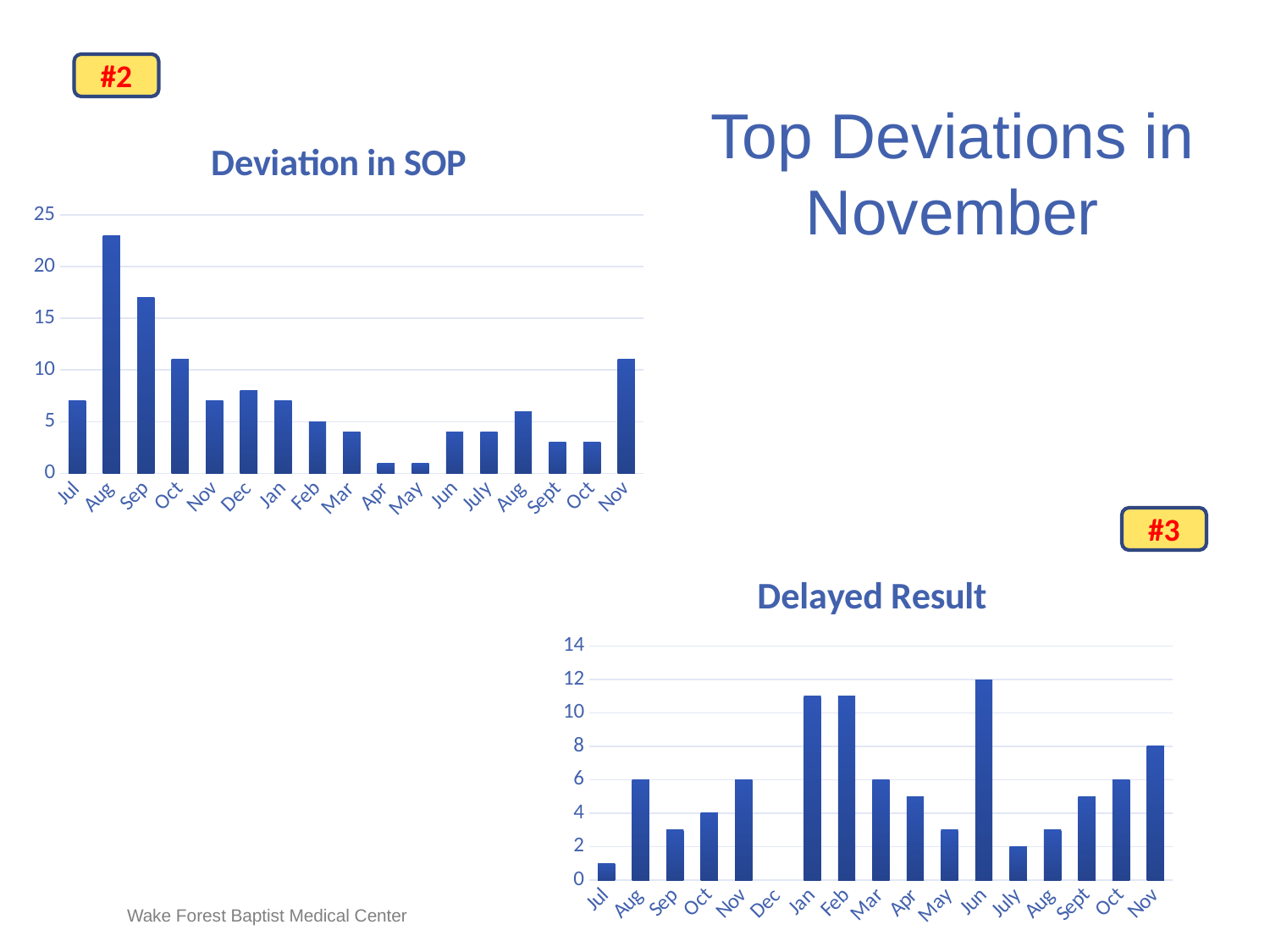
In the "Deviation in SOP" chart, which month has the highest value? Aug In the "Delayed Result" chart, what is the value for Nov (the last bar)? 8 In the "Deviation in SOP" chart, which is larger, the value for Aug or the value for Sep? Aug In the "Delayed Result" chart, is the value for Jan greater or less than 10? greater What is the title of the chart in the lower right of the slide? Delayed Result How many months are shown on the x axis of the "Deviation in SOP" chart? 17 In the "Delayed Result" chart, which month has the highest value? Jun In the "Deviation in SOP" chart, is the value for Sept greater or less than 5? less In the "Delayed Result" chart, what is the value for Jun? 12 In the "Deviation in SOP" chart, is the value for Aug greater or less than 20? greater What type of chart is the "Deviation in SOP" chart? bar chart